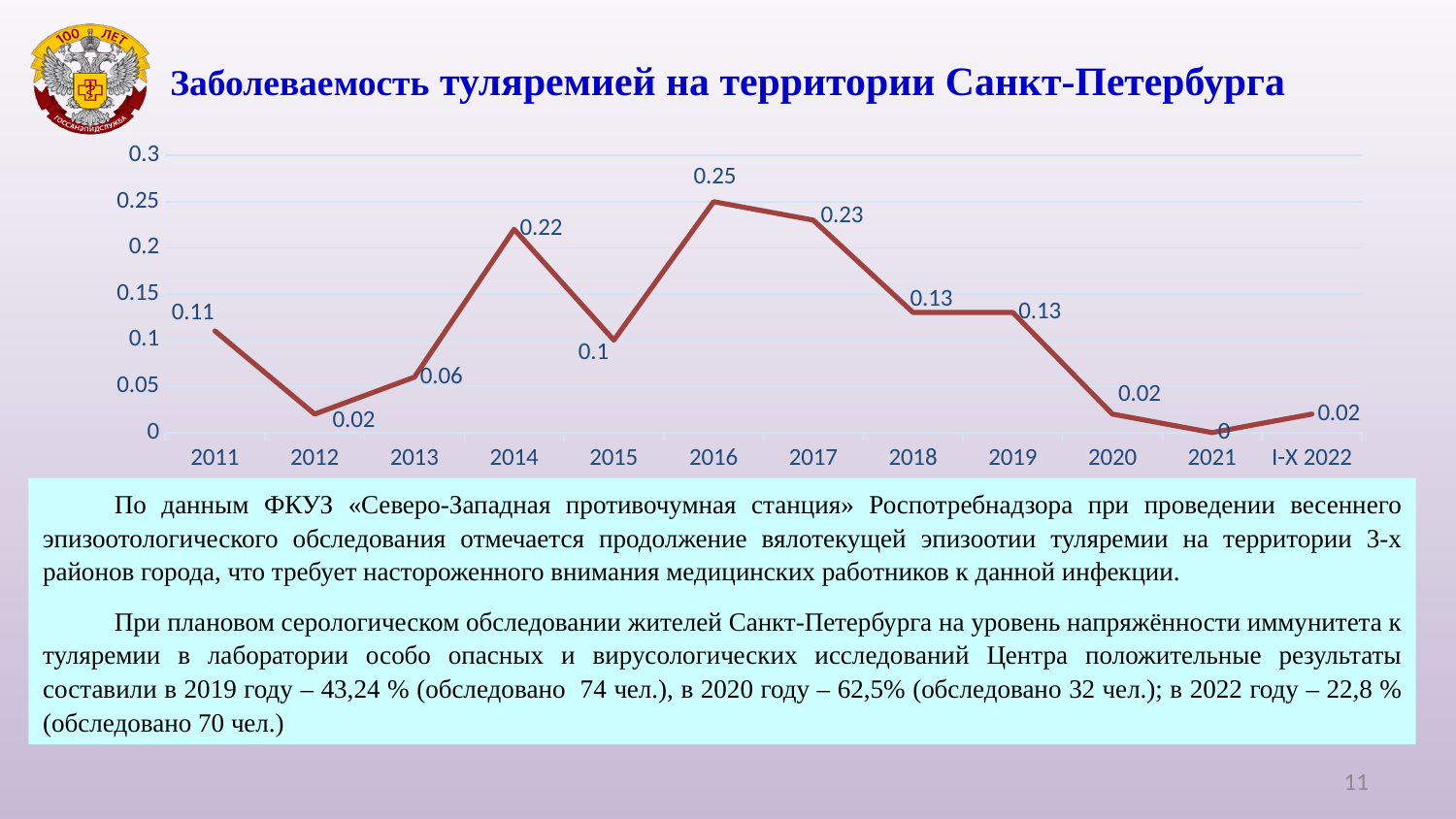
What is the value for 2016? 0.25 Do the values rise or fall from 2017 to 2021? fall Which is larger, the value for 2013 or the value for 2018? 2018 What is the difference between the values for 2016 and 2017? 0.02 Which year has the lowest value? 2021 Which year has the highest value? 2016 What is the value for 2021? 0 What is the value for 2011? 0.11 What is the value for 2014? 0.22 What type of chart is shown on the slide? line chart What is the difference between the values for 2014 and 2015? 0.12 How many data points are plotted on the chart? 12